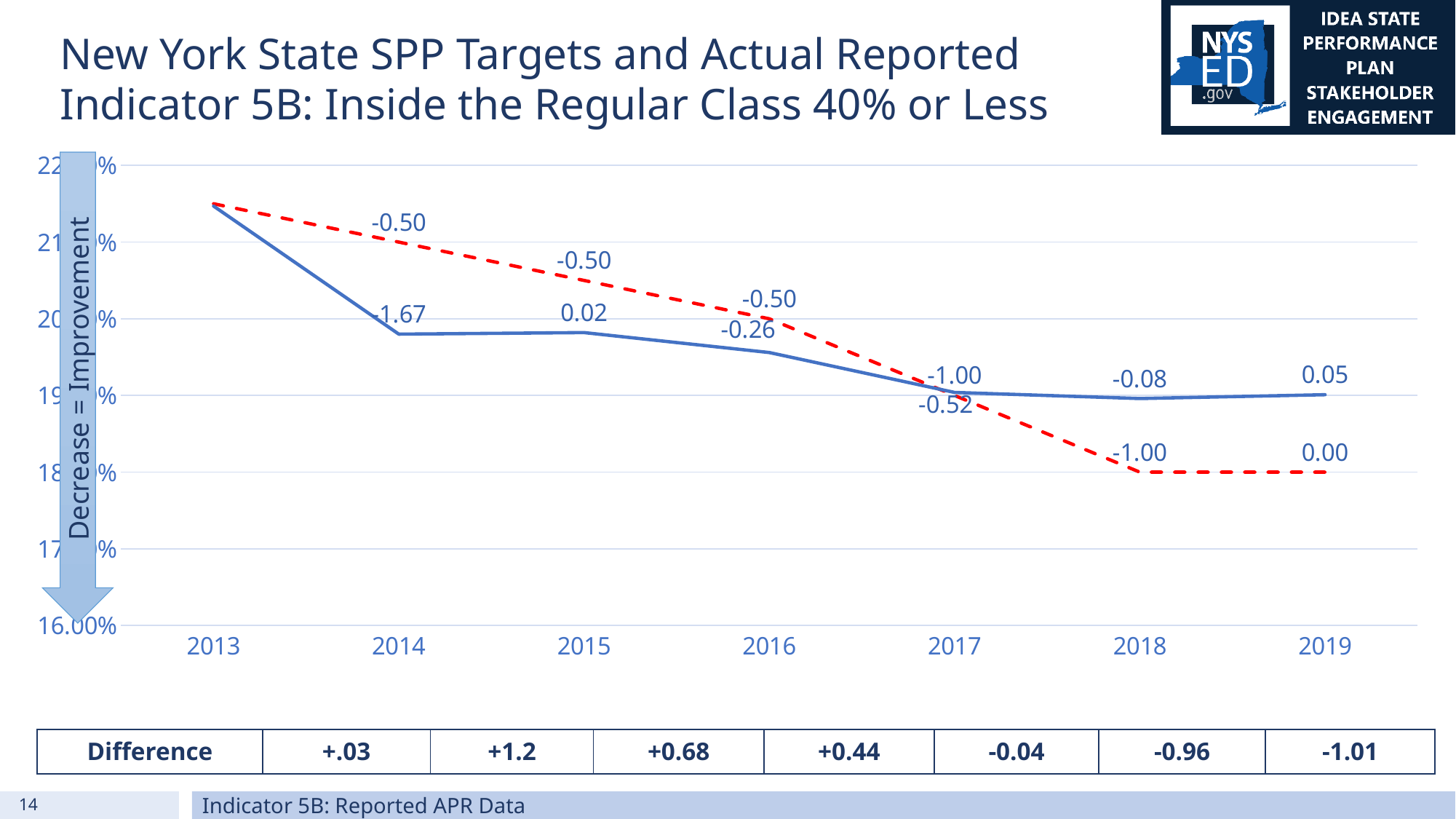
How many years are shown along the x axis of the chart? 7 Is the value of the blue solid line in 2019 greater or less than 20.00%? less Is the value of the blue solid line in 2013 greater or less than 21.00%? greater What is the first year shown on the x axis of the chart? 2013 Is the value of the red dashed line in 2018 greater or less than 19.00%? less What kind of chart is shown on the slide? line chart What change label is printed on the red dashed line at 2017? -1.00 Does the blue solid line rise or fall from 2013 to 2014? fall What is the last year shown on the x axis of the chart? 2019 In 2019, which line is higher, the blue solid line or the red dashed line? the blue solid line What change label is printed on the blue solid line at 2014? -1.67 Does the red dashed line rise or fall from 2013 to 2018? fall